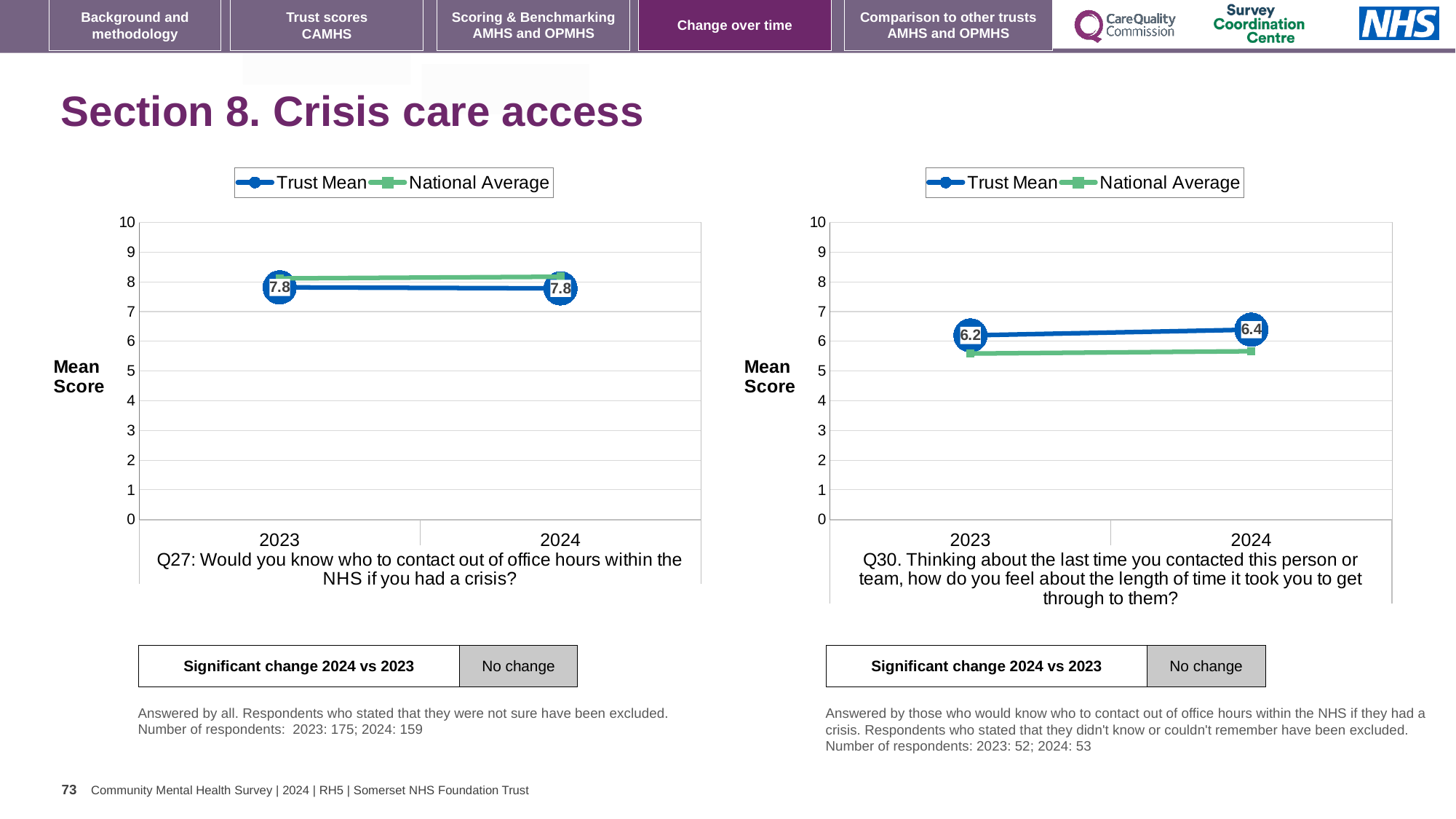
What kind of chart is the Q30 chart on the right? line chart In the Q30 chart on the right, does the Trust Mean rise or fall from 2023 to 2024? rise In the Q30 chart on the right, what is the Trust Mean score for 2024? 6.4 In the Q27 chart on the left, which series is higher in 2023, Trust Mean or National Average? National Average In the Q30 chart on the right, what is the Trust Mean score for 2023? 6.2 In the Q30 chart on the right, which series is higher in 2024, Trust Mean or National Average? Trust Mean In the Q30 chart on the right, by how much did the Trust Mean change from 2023 to 2024? 0.2 In the Q27 chart on the left, what is the Trust Mean score for 2024? 7.8 In the Q30 chart on the right, is the National Average value for 2023 greater or less than 6? less In the Q27 chart on the left, what is the Trust Mean score for 2023? 7.8 How many series does the legend of the Q27 chart on the left list? 2 In the Q27 chart on the left, is the National Average value for 2024 greater or less than 9? less